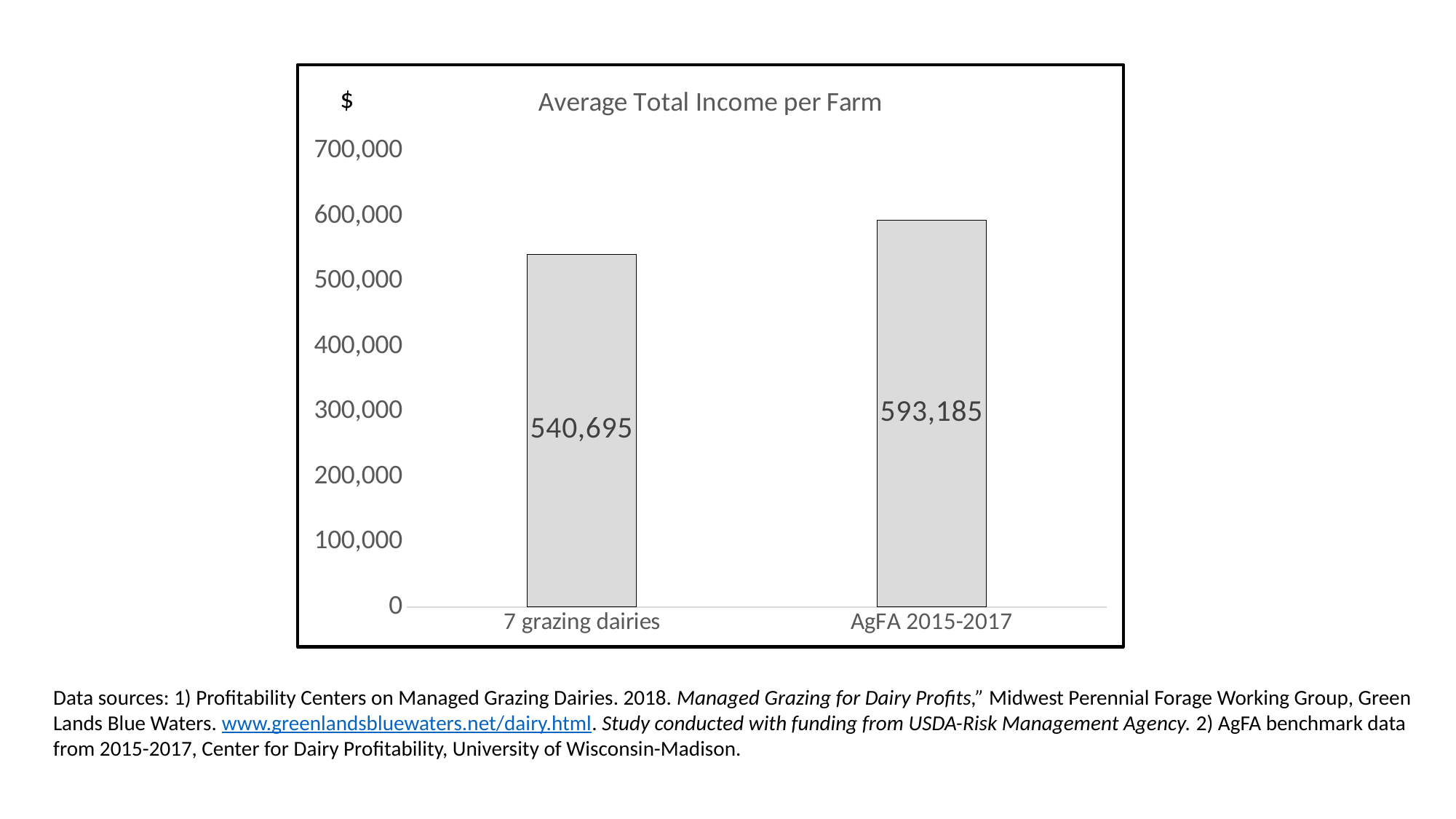
What is the difference in average total income per farm between AgFA 2015-2017 and the 7 grazing dairies? 52,490 What kind of chart is shown on the slide? Bar chart What is the title of the chart? Average Total Income per Farm What is the highest value labelled on the vertical axis? 700,000 Which category has the higher average total income per farm? AgFA 2015-2017 Is the value for the 7 grazing dairies greater or less than 500,000? greater Is the value for AgFA 2015-2017 greater or less than 600,000? less What is the average total income per farm for AgFA 2015-2017? 593,185 Is the average total income per farm larger for the 7 grazing dairies or for AgFA 2015-2017? AgFA 2015-2017 What is the average total income per farm for the 7 grazing dairies? 540,695 How many categories are shown on the chart? 2 Which category has the lower average total income per farm? 7 grazing dairies